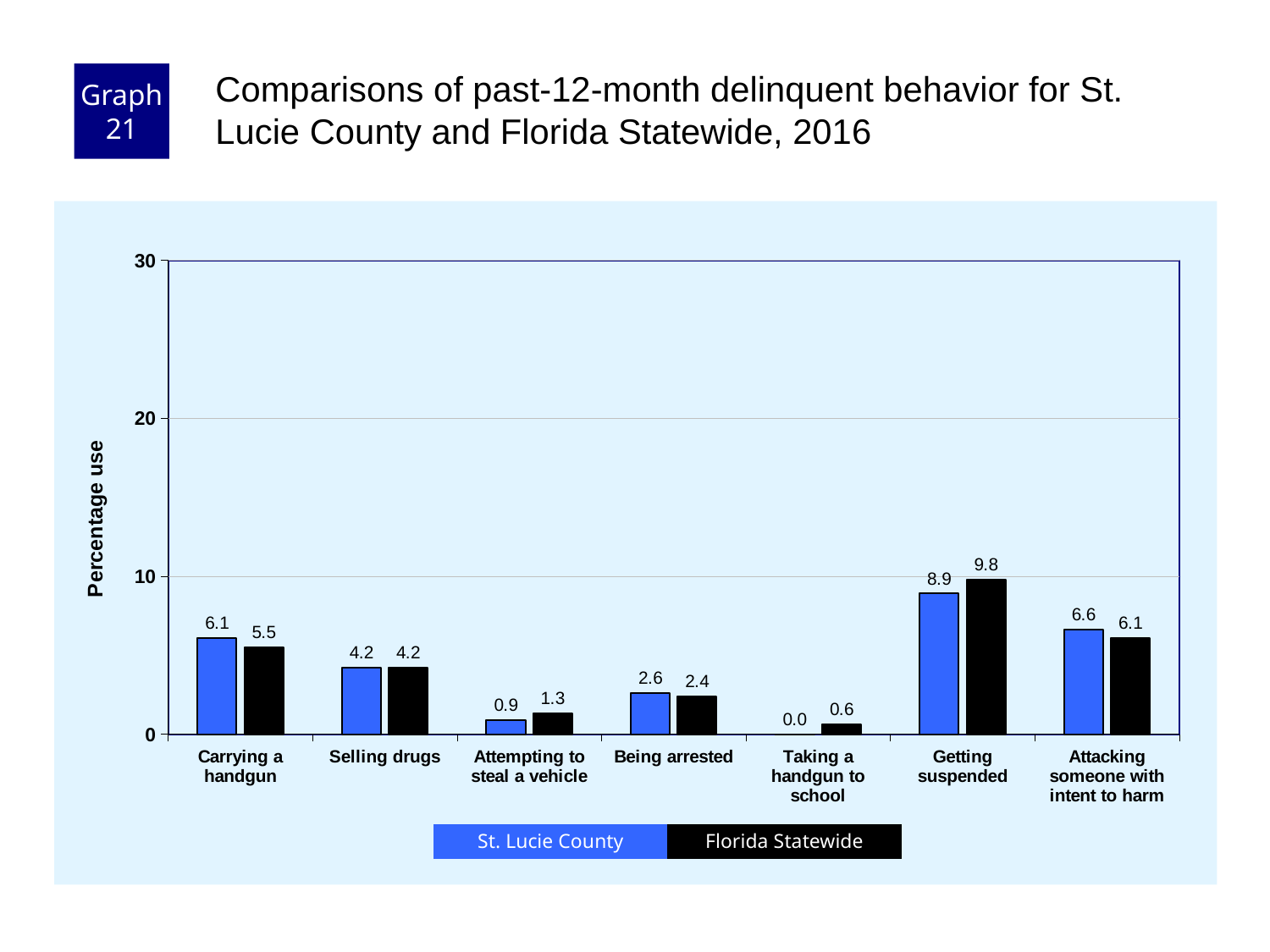
Which is larger for Carrying a handgun: St. Lucie County or Florida Statewide? St. Lucie County Which category has the highest Florida Statewide value? Getting suspended Which category has the lowest St. Lucie County value? Taking a handgun to school What is the difference between the Florida Statewide and St. Lucie County values for Getting suspended? 0.9 How many categories are shown on the x axis? 7 What is the Florida Statewide value for Attempting to steal a vehicle? 1.3 What is the label of the y axis? Percentage use What is the St. Lucie County value for Taking a handgun to school? 0.0 Is the Florida Statewide value for Getting suspended greater or less than 10? less How many series does the legend list? 2 What is the St. Lucie County value for Getting suspended? 8.9 What kind of chart is shown on the slide? bar chart